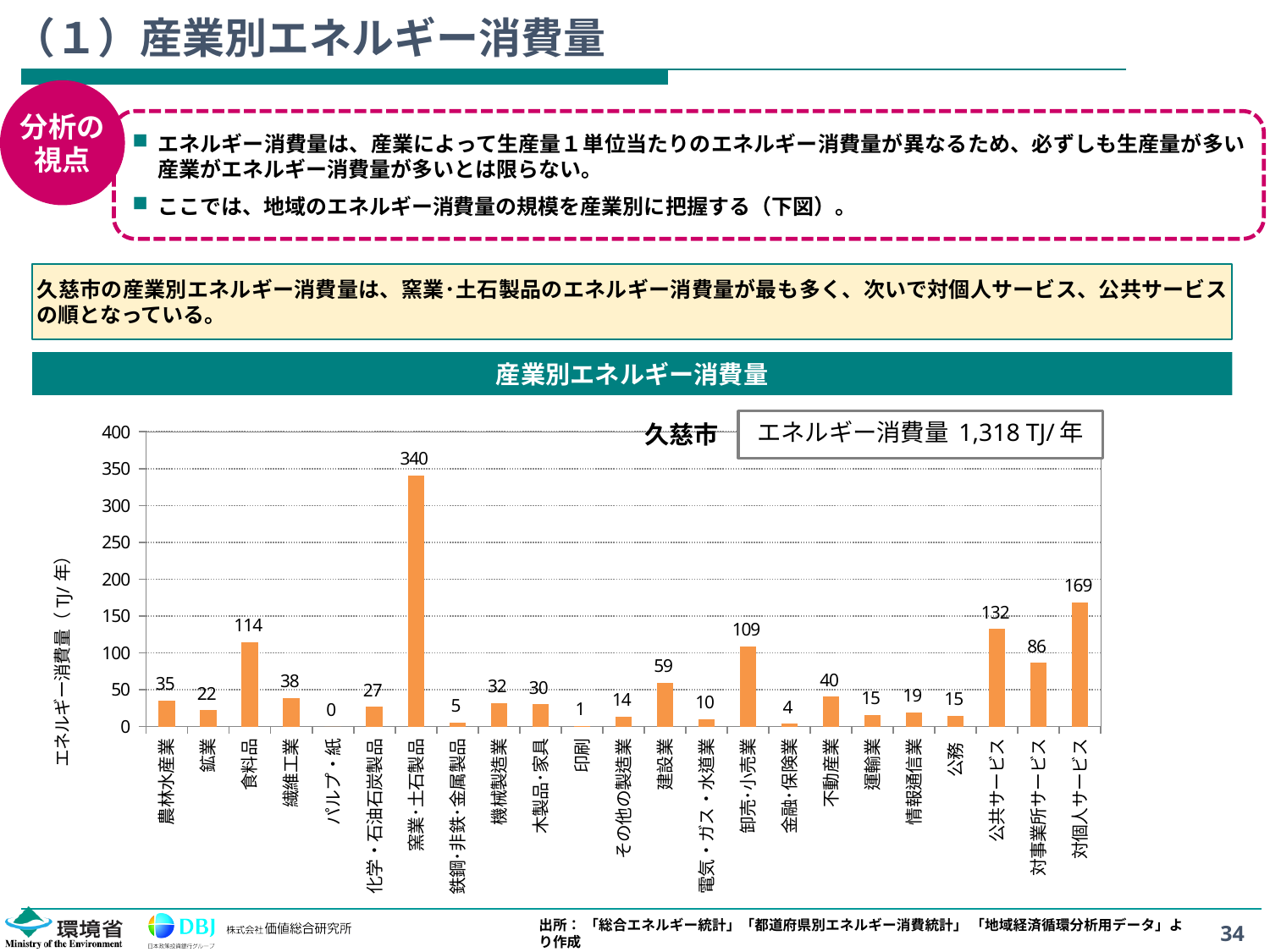
What is the unit shown on the y axis of the chart? TJ/年 Which industry has the highest energy consumption? 窯業・土石製品 How many industry categories are shown on the x axis? 23 What is the value shown for 卸売・小売業? 109 Is the value for 建設業 greater or less than 50? greater What is the difference between the values for 公共サービス and 対事業所サービス? 46 What kind of chart is shown on the slide? bar chart What is the energy consumption value for 対個人サービス? 169 Which is larger, the value for 食料品 or the value for 卸売・小売業? 食料品 What is the energy consumption value for 窯業・土石製品? 340 What total energy consumption is stated in the box at the top right of the chart? 1,318 TJ/年 Which industry has the lowest energy consumption? パルプ・紙